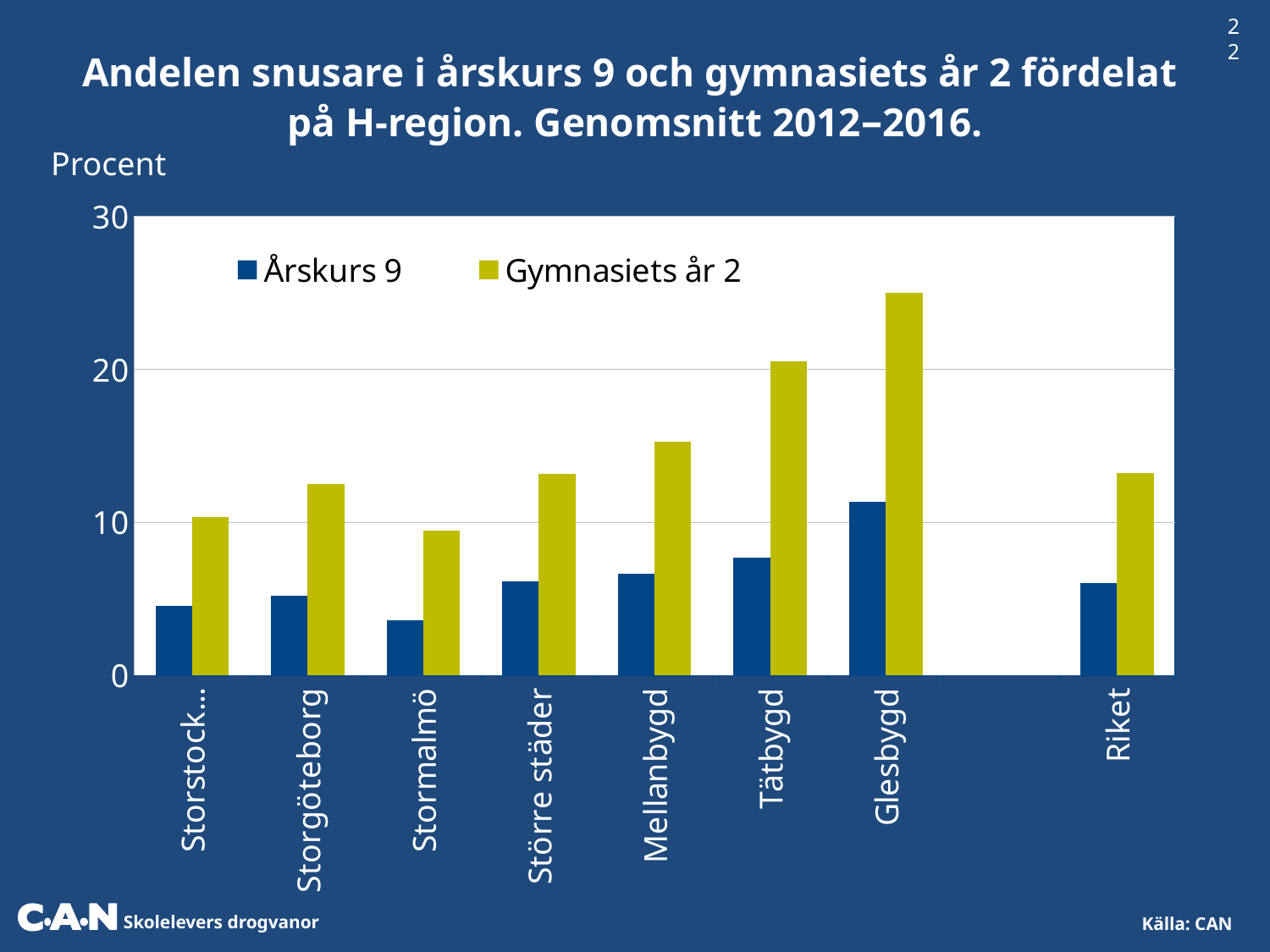
What are the two series named in the legend? Årskurs 9 and Gymnasiets år 2 Which region has the highest value for Årskurs 9? Glesbygd Which region has the lowest value for Årskurs 9? Stormalmö What kind of chart is shown on the slide? bar chart How many series does the legend list? 2 For Tätbygd, which series has the larger value, Årskurs 9 or Gymnasiets år 2? Gymnasiets år 2 Which region has the highest value for Gymnasiets år 2? Glesbygd Is the Gymnasiets år 2 value for Storgöteborg greater or less than 10? greater Is the Gymnasiets år 2 value for Mellanbygd greater or less than 20? less Is the Årskurs 9 value for Riket greater or less than 10? less How many regions (categories) are shown on the x axis? 8